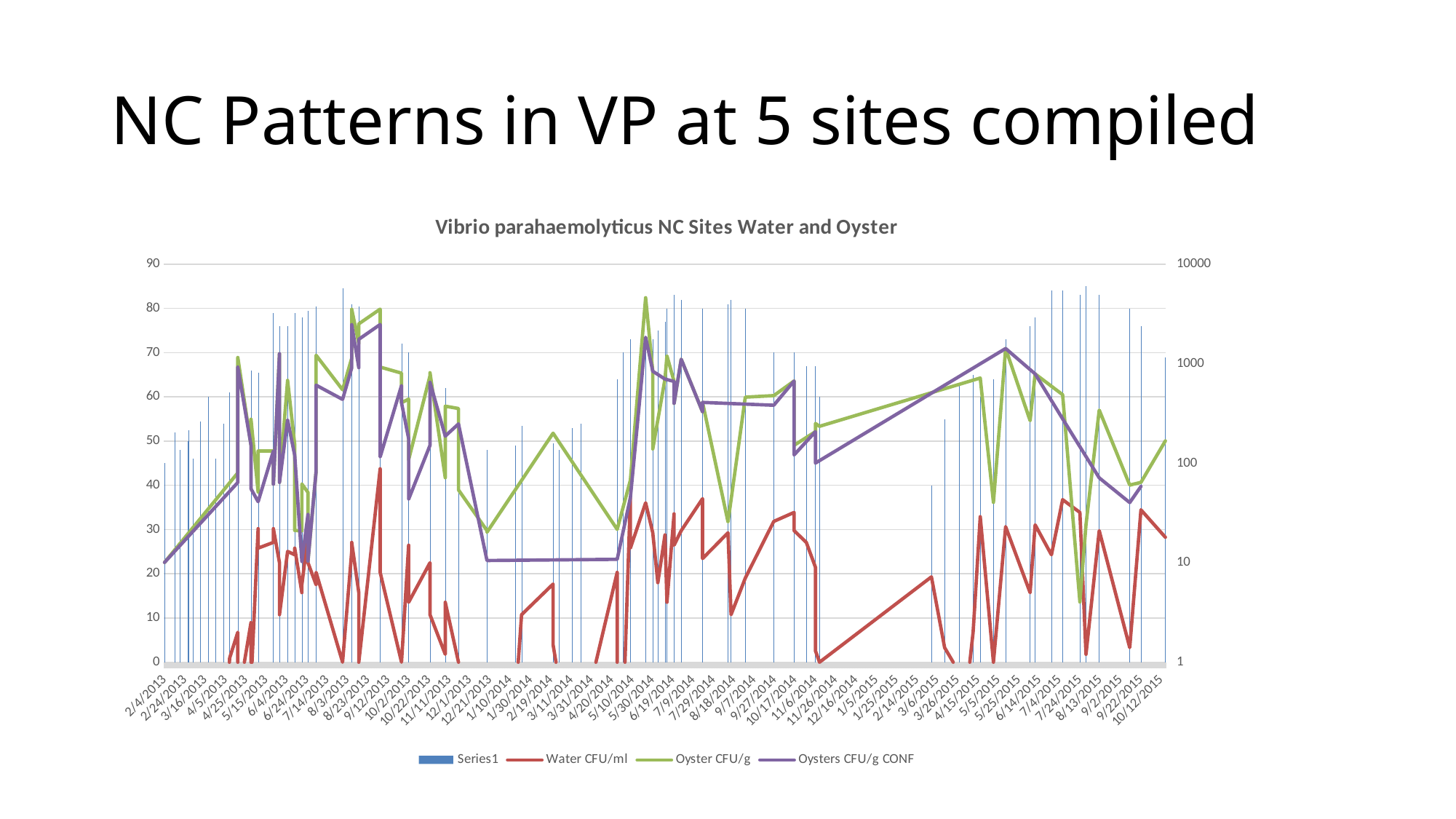
Does the Water CFU/ml line rise or fall between 12/16/2014 and 3/6/2015? rise How many series does the chart legend list? 4 Is the Water CFU/ml value around 1/30/2014 greater or less than 20 on the left axis? less What kind of chart is shown on the slide? A combination bar and line chart What is the highest value shown on the right-hand axis? 10000 Which series is plotted as bars rather than a line? Series1 Is the Oysters CFU/g CONF line around 5/5/2015 above or below the 60 gridline of the left axis? above Is the Water CFU/ml value around 10/17/2014 greater or less than 40 on the left axis? less What is the title of the chart? Vibrio parahaemolyticus NC Sites Water and Oyster Does the Oysters CFU/g CONF line rise or fall between 11/26/2014 and 5/5/2015? rise